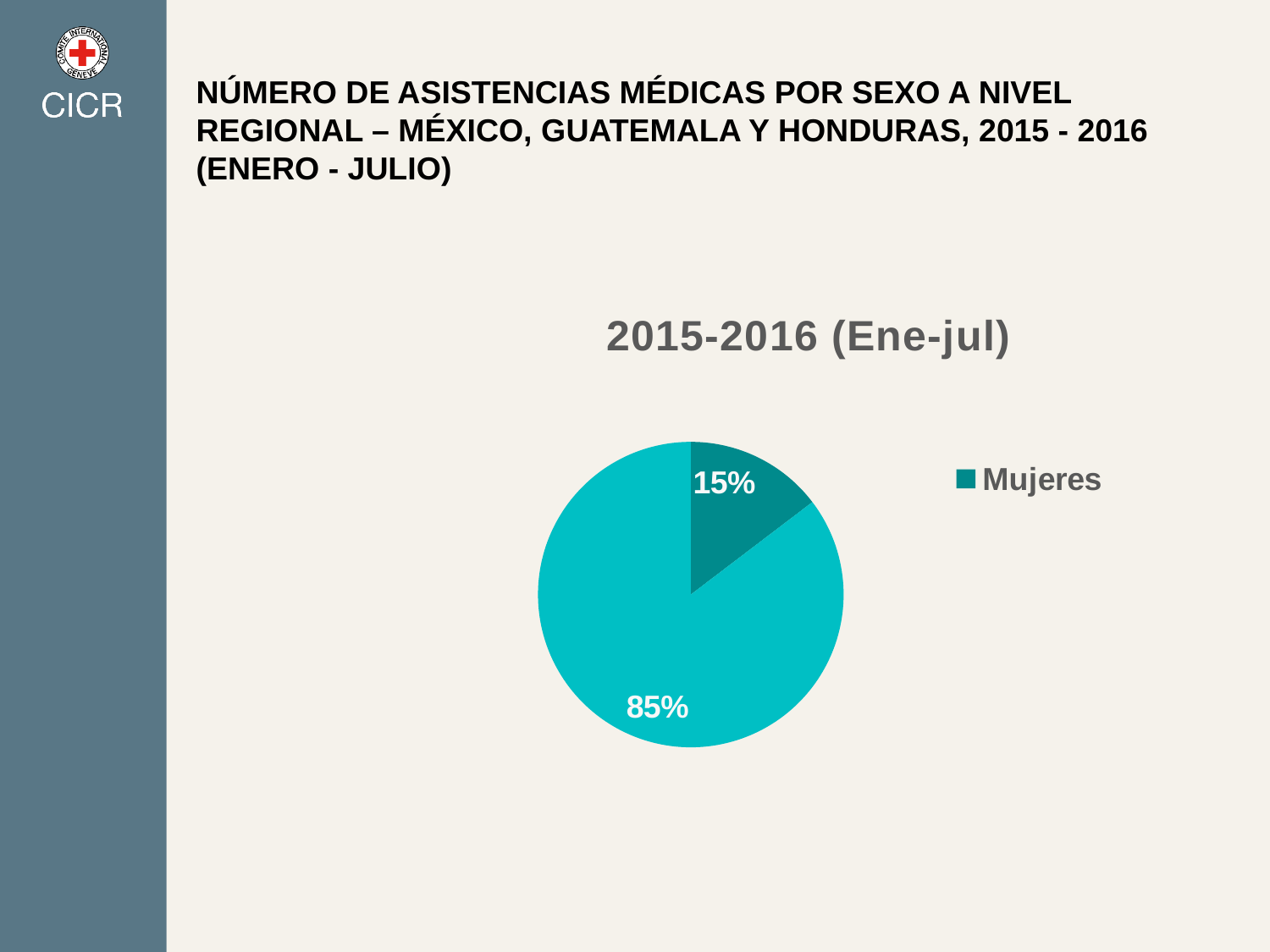
What do the two slice percentages add up to? 100% What percentage is shown on the largest slice of the pie chart? 85% What is the only entry shown in the chart legend? Mujeres Which slice is larger, the one labelled 85% or the one labelled 15%? 85% What percentage is shown on the smallest slice of the pie chart? 15% How many entries does the chart legend list? 1 What share of the pie does the Mujeres slice represent? 15% How many slices does the pie chart have? 2 What is the title of the chart? 2015-2016 (Ene-jul) What is the difference in percentage points between the two slices of the pie chart? 70 percentage points What kind of chart is shown on the slide? pie chart Is the share of the Mujeres slice greater or less than 50%? less